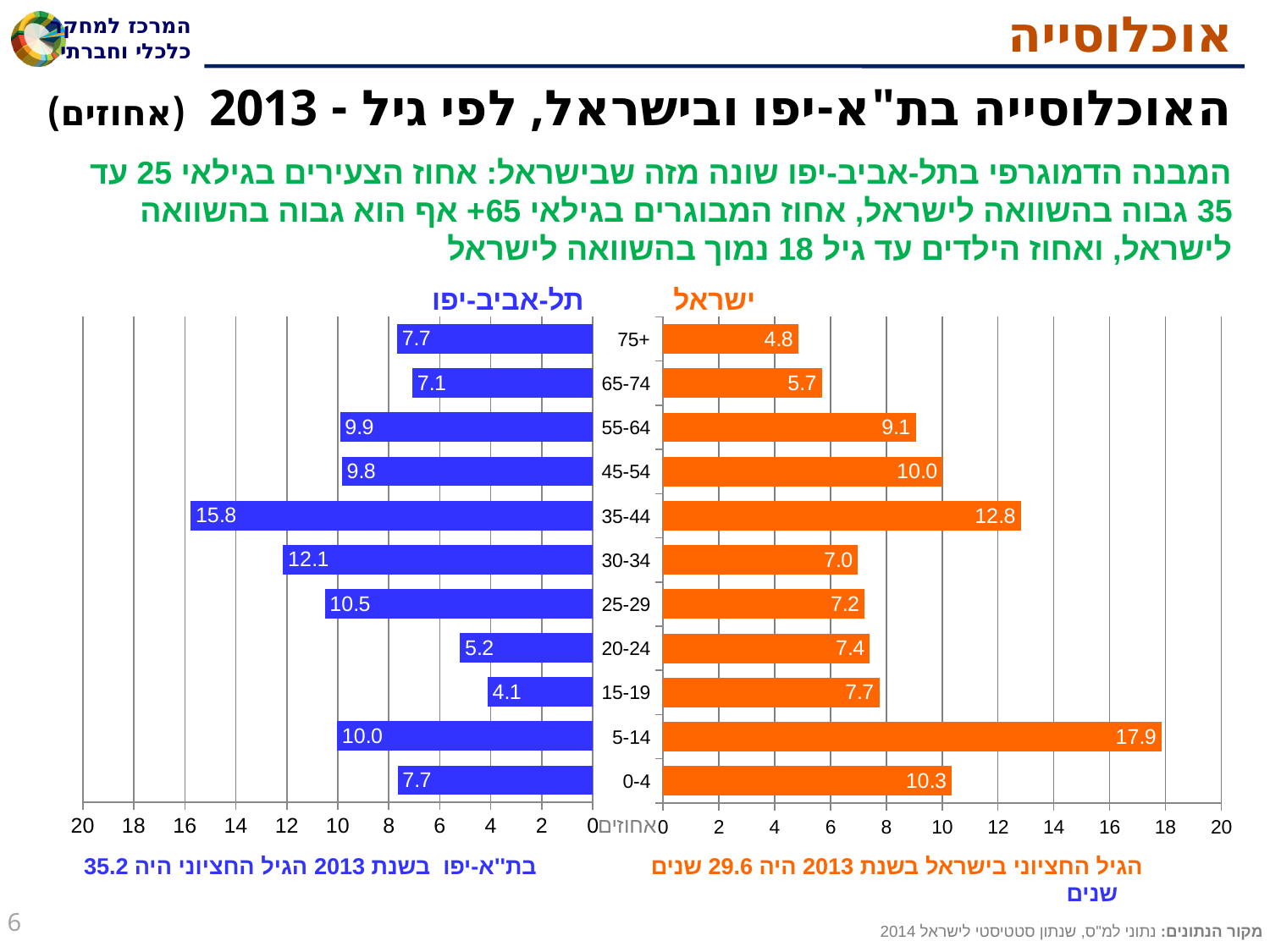
Which age group has the highest value in the Tel Aviv-Yafo (תל-אביב-יפו) series? 35-44 What colour are the bars for the Israel (ישראל) series? Orange Which age group has the lowest value in the Israel (ישראל) series? 75+ What is the value for the 35-44 age group in the Tel Aviv-Yafo (תל-אביב-יפו) series? 15.8 Which age group has the lowest value in the Tel Aviv-Yafo (תל-אביב-יפו) series? 15-19 How many age groups are shown on the chart? 11 What is the difference between the Tel Aviv-Yafo and Israel values for the 30-34 age group? 5.1 What is the value for the 5-14 age group in the Israel (ישראל) series? 17.9 For the 5-14 age group, which is larger: the Tel Aviv-Yafo value or the Israel value? Israel Which age group has the highest value in the Israel (ישראל) series? 5-14 What kind of chart is shown on the slide? Bar chart What is the value for the 75+ age group in the Israel (ישראל) series? 4.8